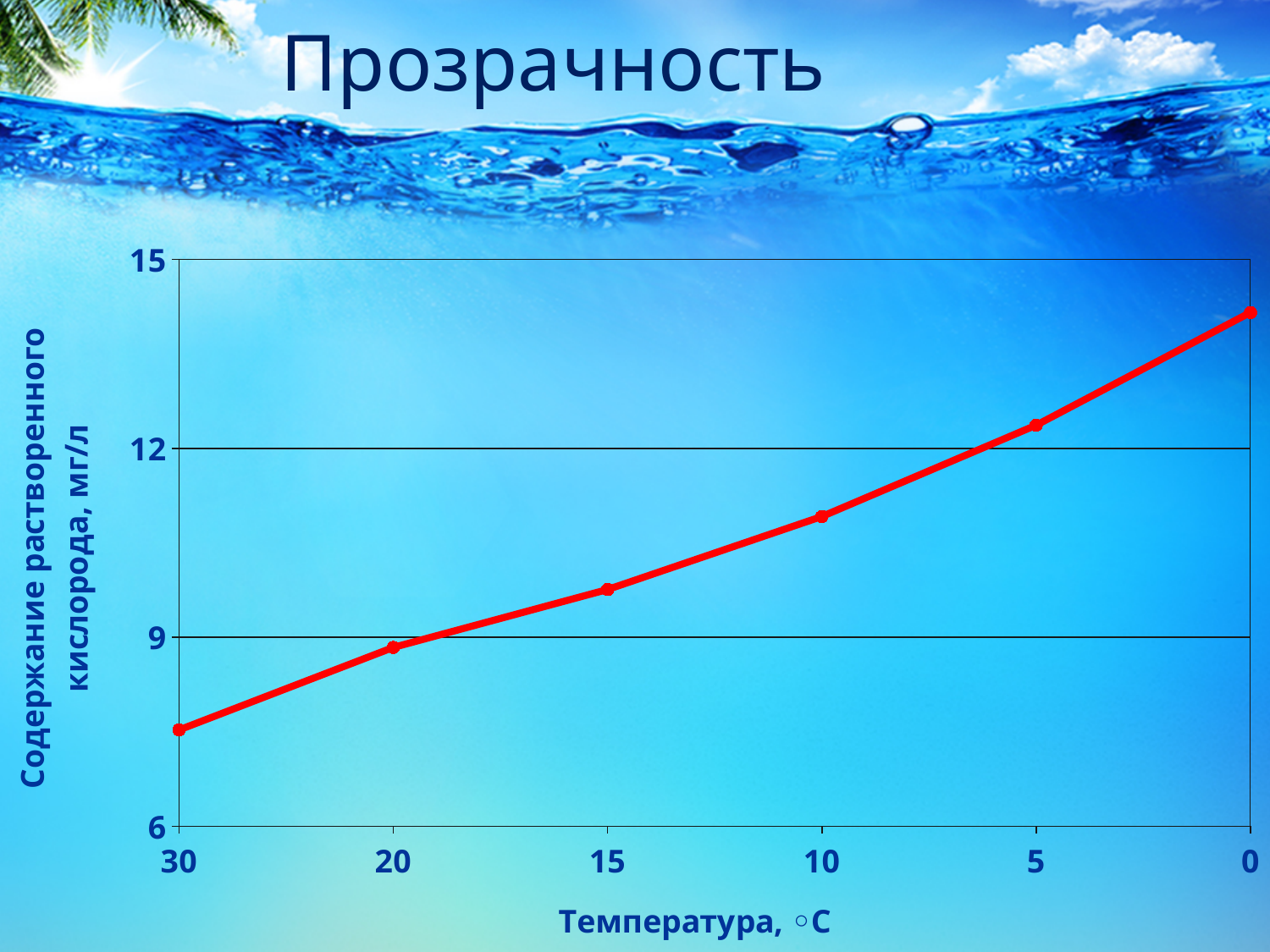
Which has the larger dissolved oxygen content, 5 °C or 20 °C? 5 °C How many data points are plotted on the line? 6 What kind of chart is shown on the slide? line chart Does the dissolved oxygen content rise or fall as you move from left to right along the x axis (from 30 °C to 0 °C)? rises Is the dissolved oxygen content at 0 °C greater or less than 12? greater At which temperature is the dissolved oxygen content lowest? 30 At which temperature is the dissolved oxygen content highest? 0 What is the title of the x axis? Температура, ○С What is the title of the y axis? Содержание растворенного кислорода, мг/л Is the dissolved oxygen content at 10 °C greater or less than 12? less Is the dissolved oxygen content at 15 °C greater or less than 9? greater